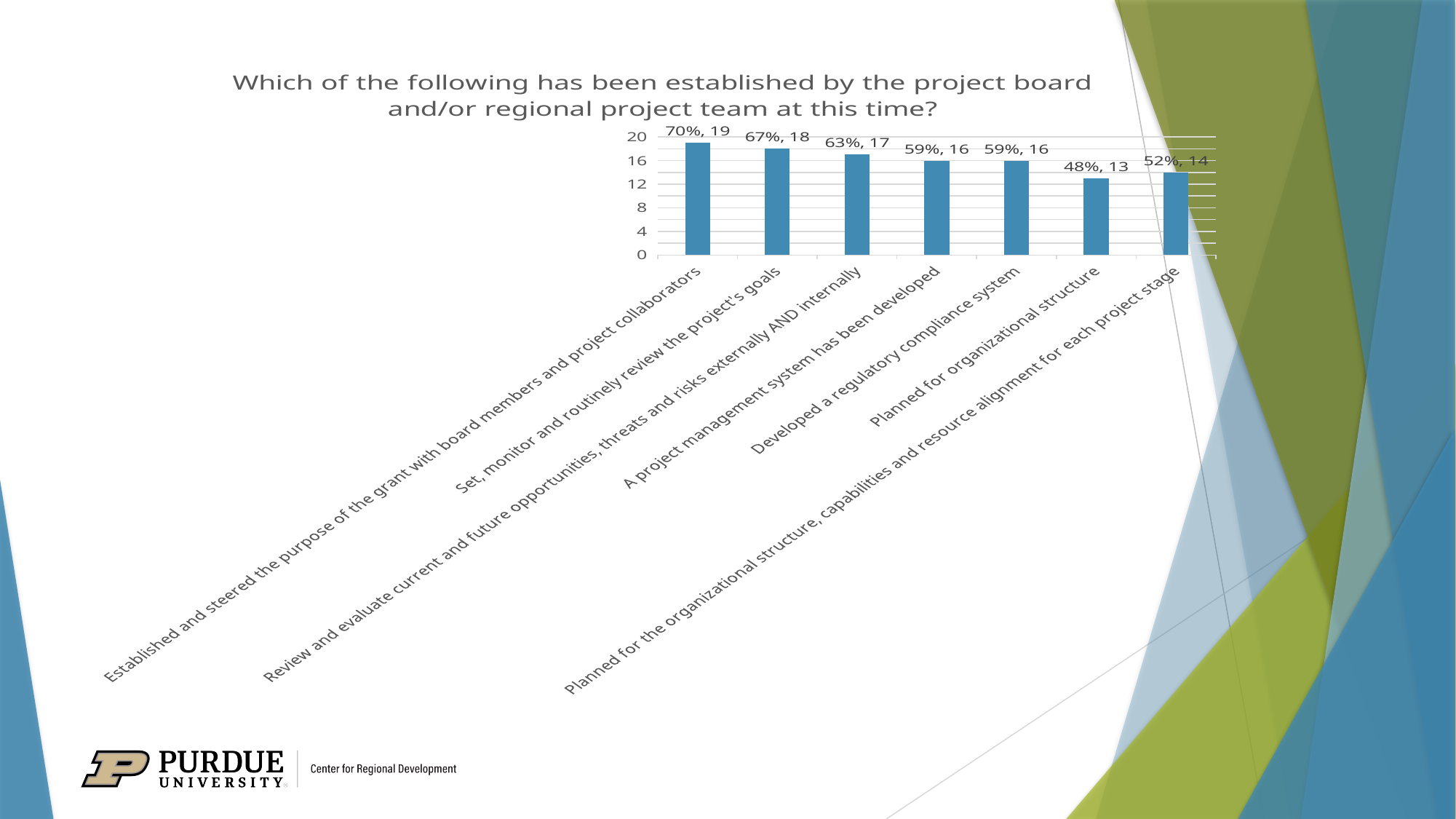
What is the data label for 'Developed a regulatory compliance system'? 59%, 16 What kind of chart is shown on the slide? bar chart Which category has the lowest value? Planned for organizational structure Which category has the highest value? Established and steered the purpose of the grant with board members and project collaborators What is the data label for 'Planned for the organizational structure, capabilities and resource alignment for each project stage'? 52%, 14 How many categories (bars) does the chart show? 7 What is the title of the chart? Which of the following has been established by the project board and/or regional project team at this time? Is the value for 'Planned for organizational structure' greater or less than 16? less What is the difference in count between 'Set, monitor and routinely review the project's goals' and 'Planned for organizational structure'? 5 Which is larger: the count for 'Review and evaluate current and future opportunities, threats and risks externally AND internally' or for 'A project management system has been developed'? Review and evaluate current and future opportunities, threats and risks externally AND internally What is the data label for 'Planned for organizational structure'? 48%, 13 What is the data label for 'Established and steered the purpose of the grant with board members and project collaborators'? 70%, 19